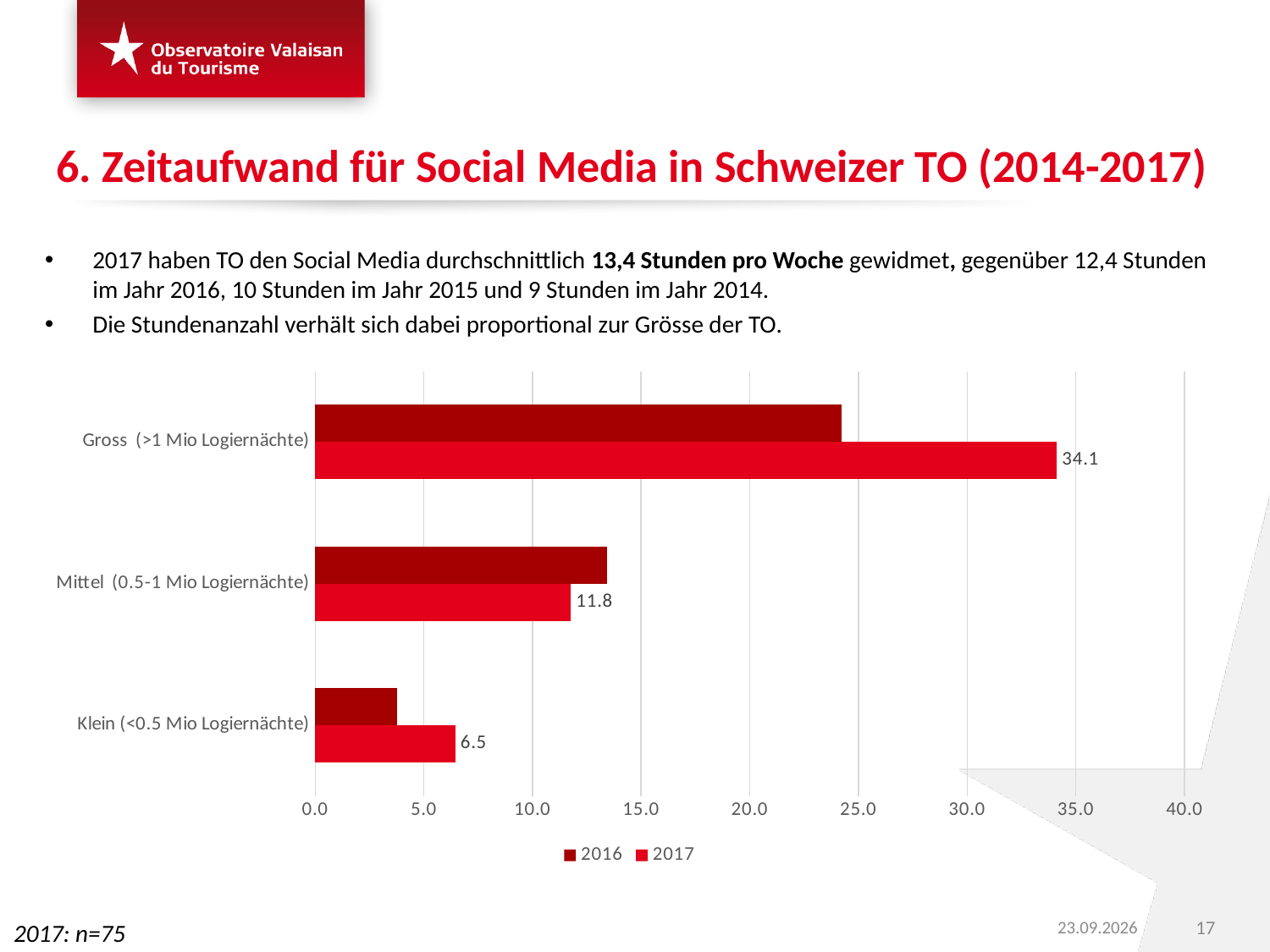
For Gross (>1 Mio Logiernächte), which series has the larger value, 2016 or 2017? 2017 What is the 2017 value for Mittel (0.5-1 Mio Logiernächte)? 11.8 What is the 2017 value for Gross (>1 Mio Logiernächte)? 34.1 Is the 2016 value for Gross (>1 Mio Logiernächte) greater or less than 25.0? less How many series does the legend list? 2 For Mittel (0.5-1 Mio Logiernächte), which series has the larger value, 2016 or 2017? 2016 What kind of chart is shown on the slide? Bar chart What is the 2017 value for Klein (<0.5 Mio Logiernächte)? 6.5 Which category has the lowest 2016 value? Klein (<0.5 Mio Logiernächte) Is the 2016 value for Klein (<0.5 Mio Logiernächte) greater or less than 5.0? less What is the difference between the 2017 values for Gross (>1 Mio Logiernächte) and Mittel (0.5-1 Mio Logiernächte)? 22.3 Which category has the highest 2017 value? Gross (>1 Mio Logiernächte)